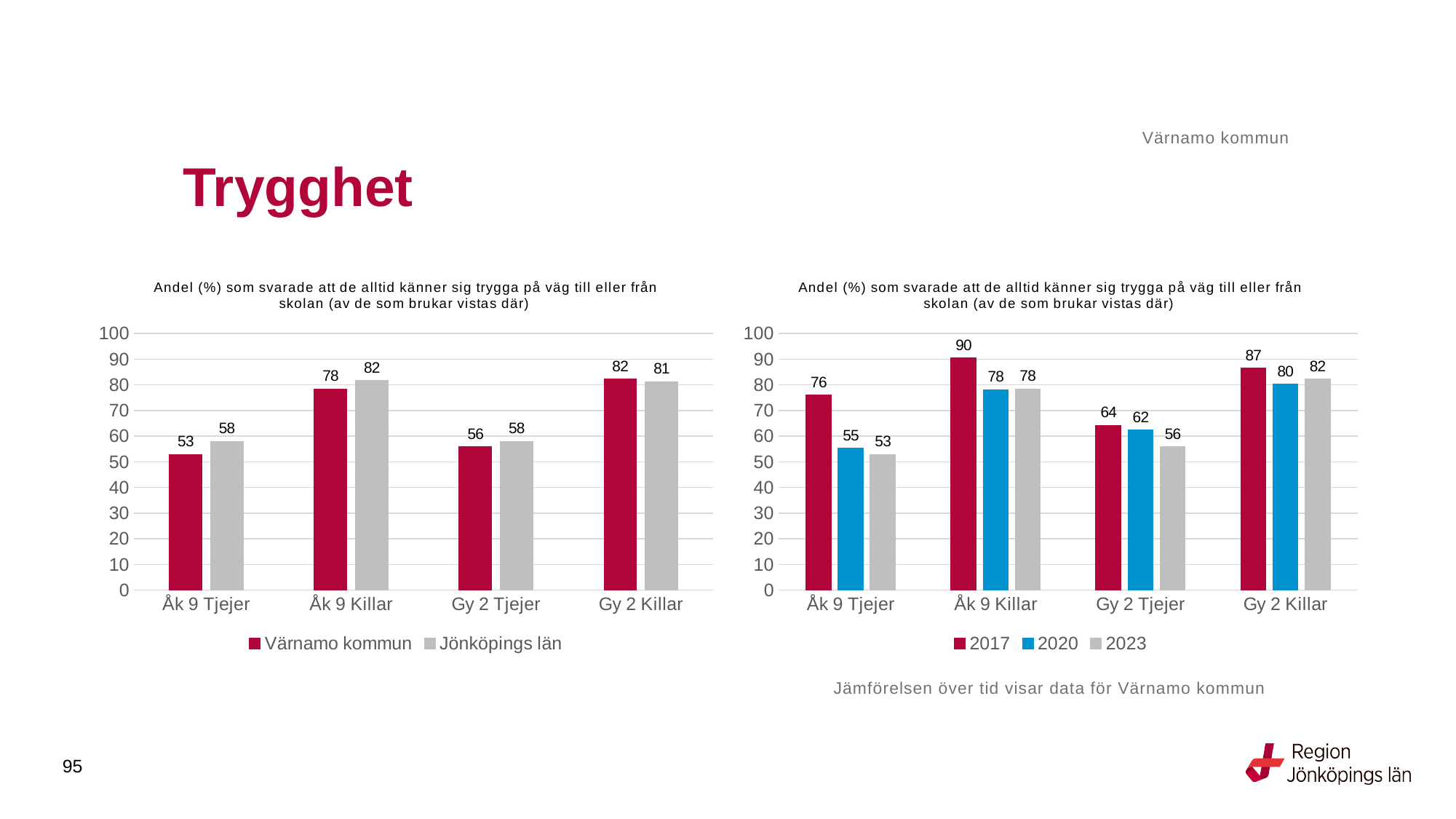
In the left chart, what is the value for Värnamo kommun for Åk 9 Tjejer? 53 In the right chart, what is the difference between 2017 and 2020 for Åk 9 Tjejer? 21 What kind of chart is the right chart? Bar chart In the left chart, how many series does the legend list? 2 In the right chart, which category has the lowest value for 2023? Åk 9 Tjejer In the left chart, what is the value for Jönköpings län for Åk 9 Killar? 82 In the right chart, what is the value for 2017 for Åk 9 Killar? 90 In the right chart, which is larger for Gy 2 Killar: the 2020 value or the 2023 value? 2023 In the left chart, what is the difference between Jönköpings län and Värnamo kommun for Åk 9 Tjejer? 5 In the right chart, how many categories are shown on the x axis? 4 In the left chart, which category has the highest value for Värnamo kommun? Gy 2 Killar In the right chart, what is the value for 2023 for Gy 2 Tjejer? 56